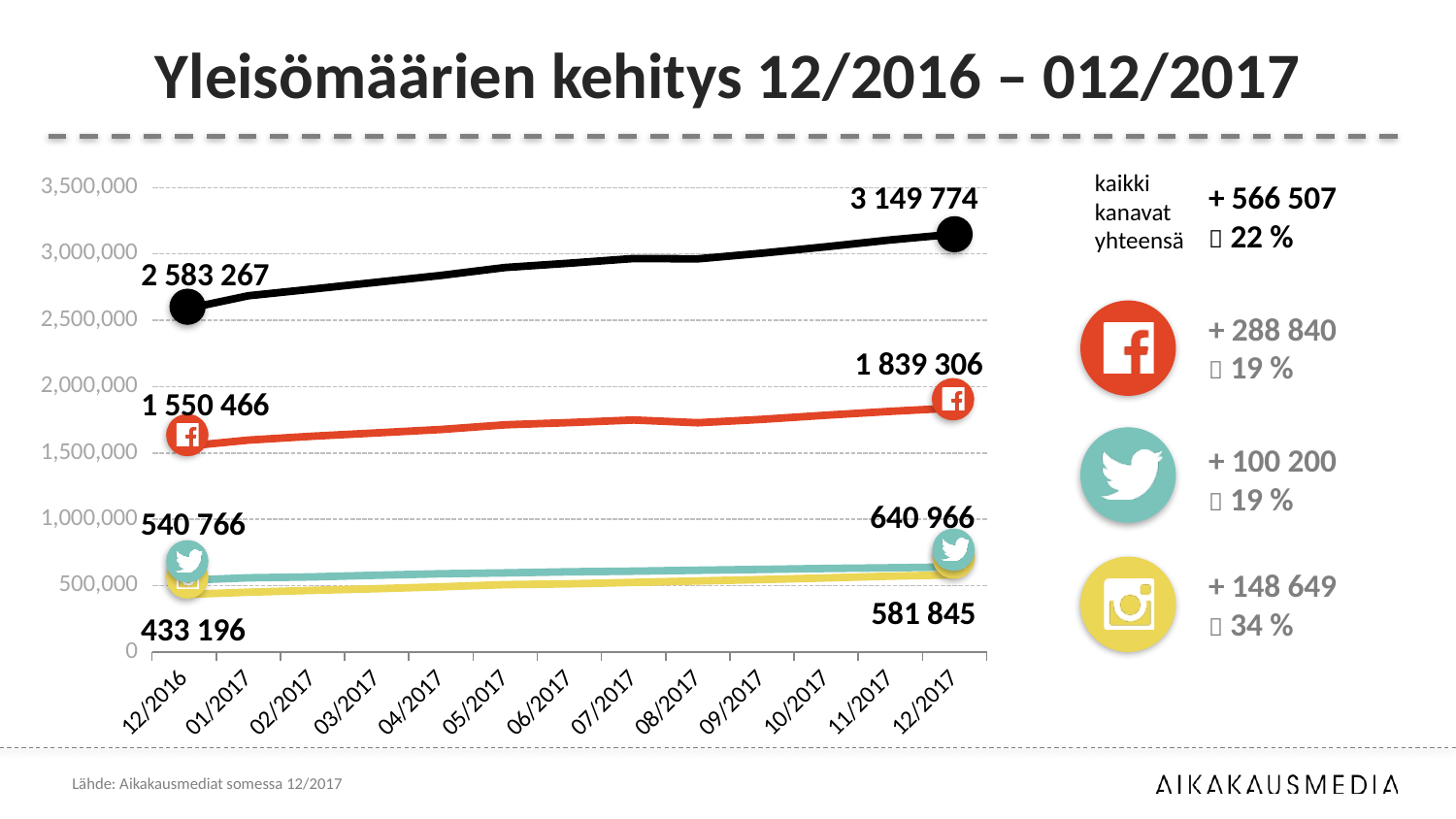
What is the value of the Facebook (red) line at 12/2016? 1 550 466 How many months are shown on the x axis? 13 At 12/2017, which is larger: the Twitter value or the Instagram value? Twitter What kind of chart is shown on the slide? line chart What is the value of the Instagram (yellow) line at 12/2016? 433 196 What is the value of the Twitter (teal) line at 12/2017? 640 966 Do the lines rise or fall from 12/2016 to 12/2017? rise By how much did the black total line increase from 12/2016 to 12/2017? 566 507 What is the value of the black (all channels total) line at 12/2017? 3 149 774 What is the title of the chart slide? Yleisömäärien kehitys 12/2016 – 012/2017 Is the Facebook (red) line value at 06/2017 greater or less than 1,500,000? greater By how much did the Facebook value increase from 12/2016 to 12/2017? 288 840